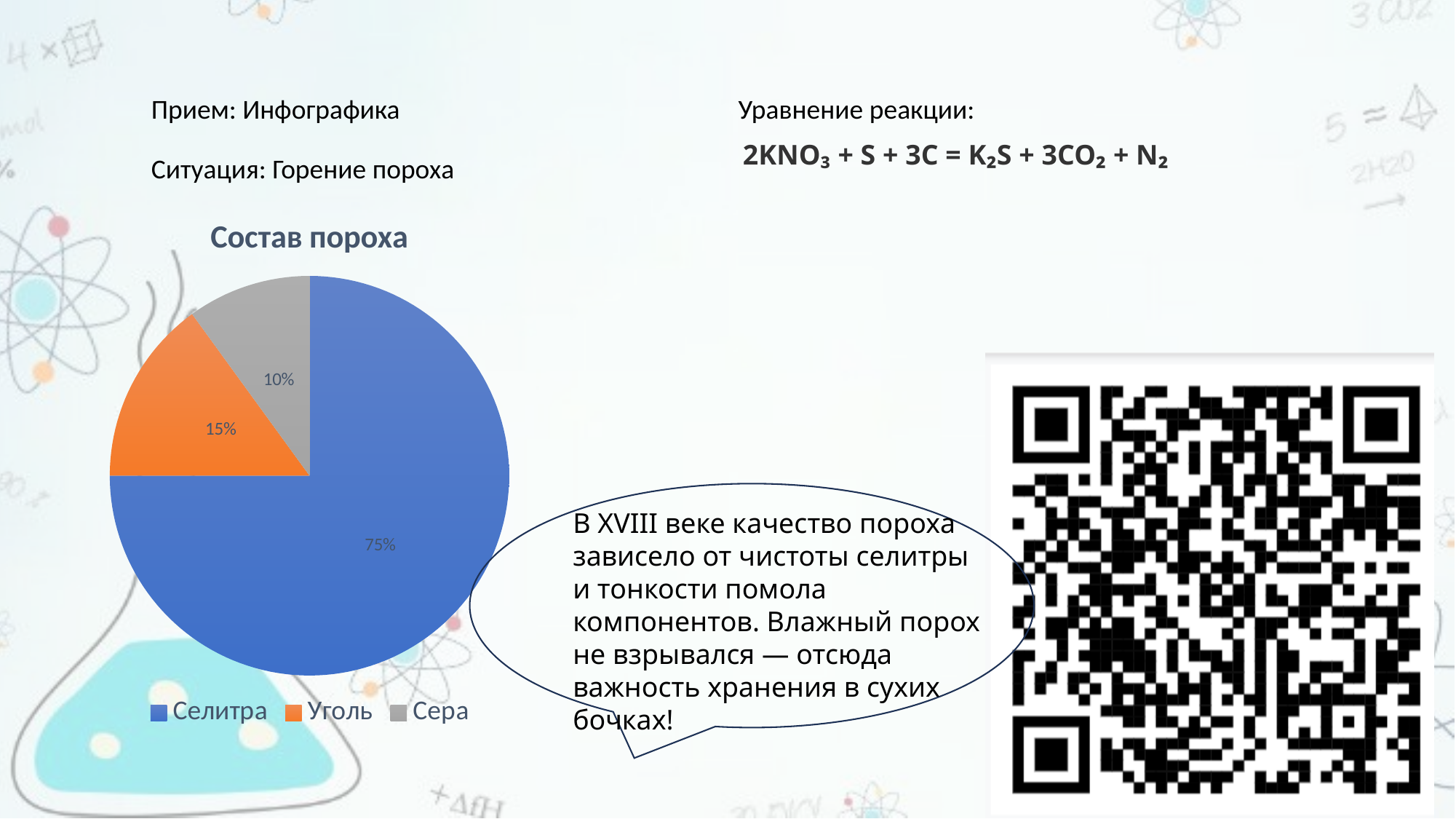
Which component has the smallest share of the pie? Сера Which component has the largest share of the pie? Селитра Which colour represents Уголь in the legend? orange What is the difference between the shares of Уголь and Сера? 5% What is the difference between the shares of Селитра and Уголь? 60% What is the value shown for Уголь? 15% How many slices does the pie chart have? 3 What is the value shown for Сера? 10% What is the title of the pie chart? Состав пороха What share of the pie does Селитра take? 75% Which is larger, the share of Уголь or the share of Сера? Уголь What type of chart is shown on the slide? pie chart